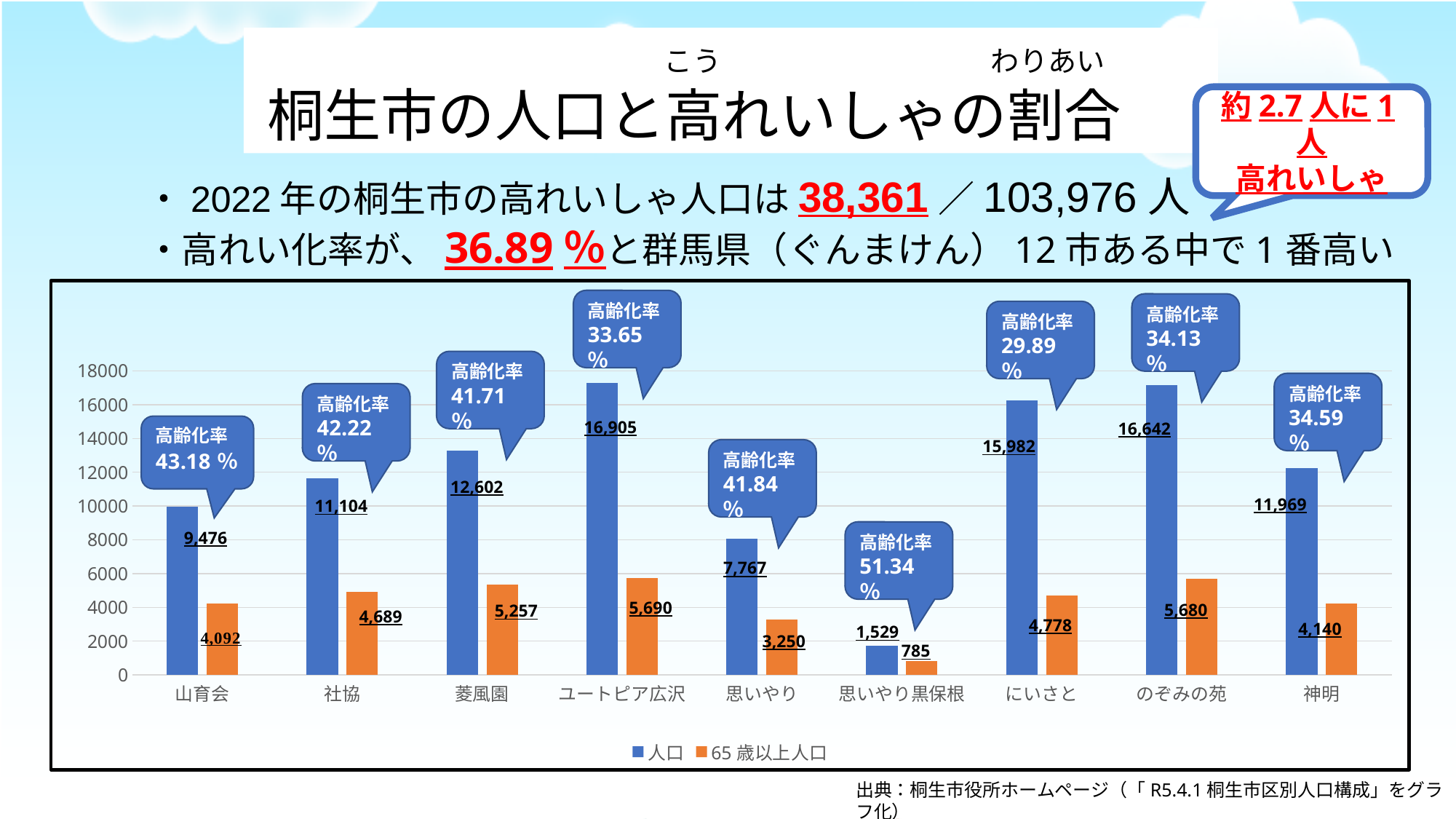
What is the difference between the 人口 and 65歳以上人口 values for 山育会? 5,384 How many series does the chart legend list? 2 What is the 65歳以上人口 value for 社協? 4,689 Which series is shown in orange in the chart legend? 65歳以上人口 Which is larger, the 65歳以上人口 value for ユートピア広沢or for のぞみの苑? ユートピア広沢 Which category has the highest 人口 value? ユートピア広沢 How many categories are shown on the x axis of the chart? 9 What 高齢化率 is shown in the callout for 思いやり黒保根? 51.34% Which category has the lowest 65歳以上人口 value? 思いやり黒保根 What kind of chart is shown on the slide? Bar chart What is the 人口 value for 神明? 11,969 What is the 人口 value for ユートピア広沢? 16,905